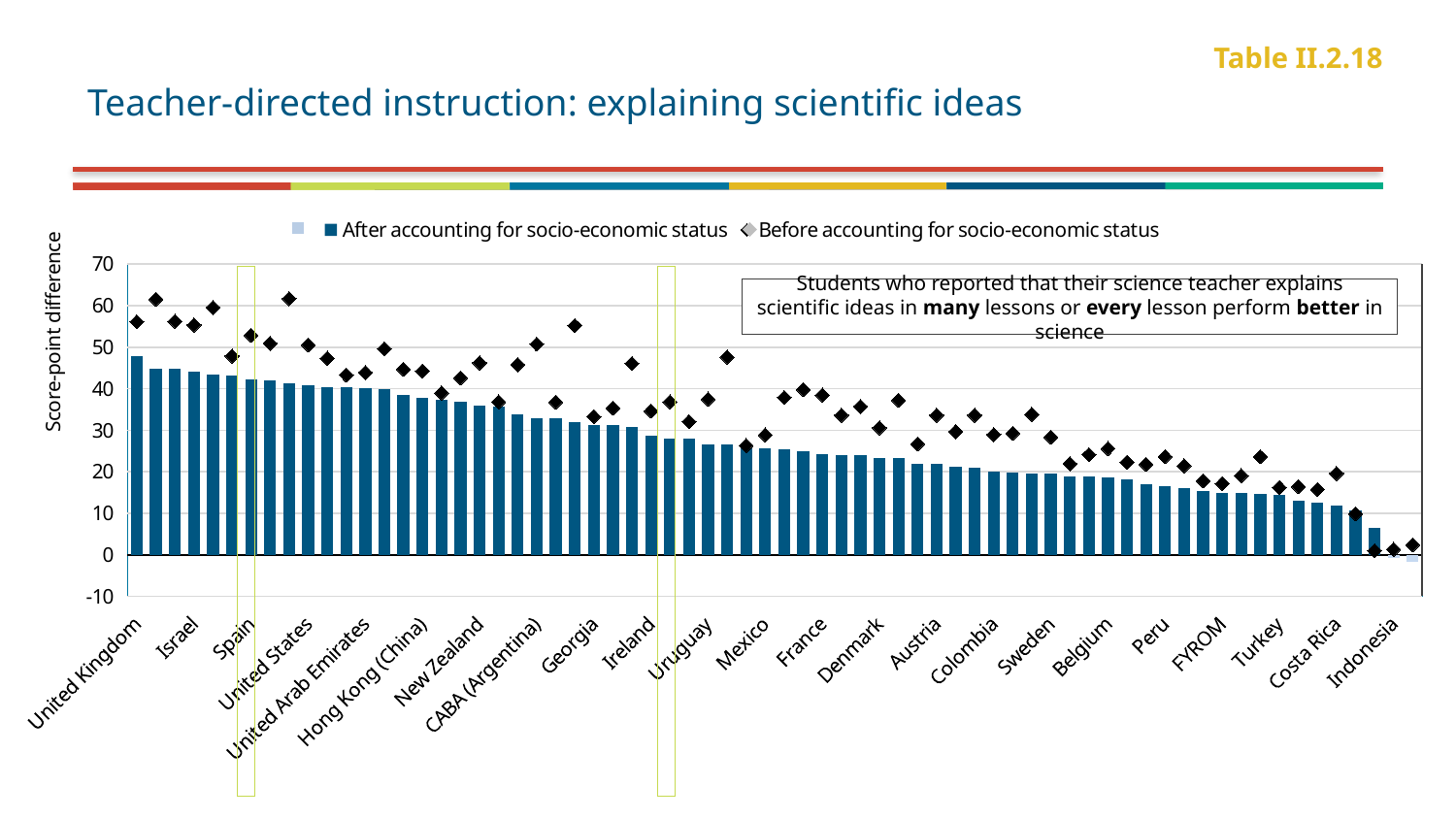
Which labelled country has the highest bar (after accounting for socio-economic status)? United Kingdom Is the 'Before accounting for socio-economic status' value for Israel greater or less than 50? greater What is the label of the vertical axis? Score-point difference Which has the larger bar value, Mexico or Turkey? Mexico What is the title of the chart on the slide? Teacher-directed instruction: explaining scientific ideas Is the bar value for Mexico greater or less than 30? less What kind of chart is shown on the slide? bar chart Which series is shown with diamond markers rather than bars? Before accounting for socio-economic status Do the bar values rise or fall moving from left to right along the x axis? fall Is the bar value for the United Kingdom greater or less than 40? greater Which labelled country has the lowest bar (after accounting for socio-economic status)? Indonesia